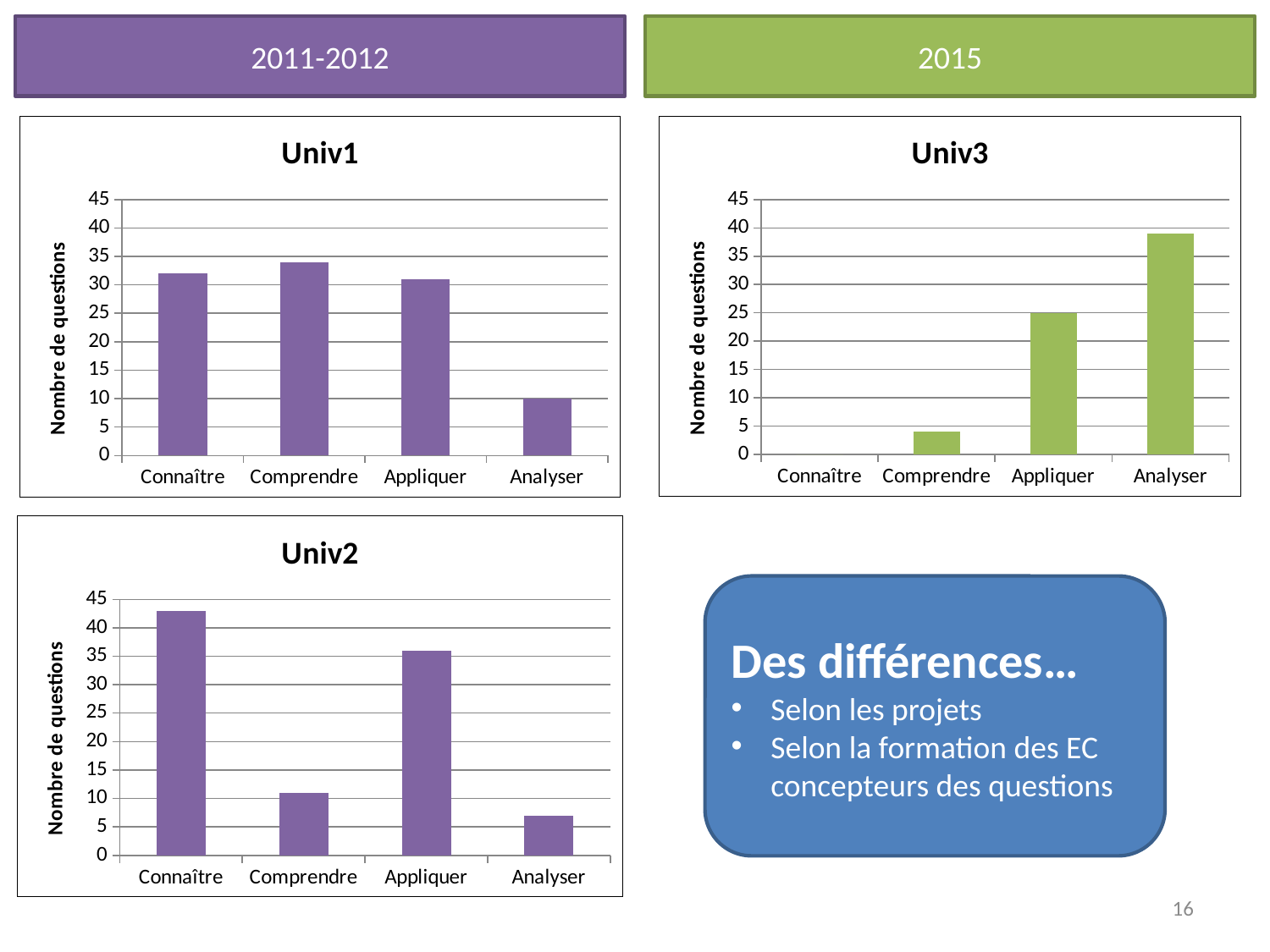
In the Univ2 chart, which category has the highest value? Connaître In the Univ2 chart, which is larger, Appliquer or Comprendre? Appliquer In the Univ2 chart, which category has the lowest value? Analyser What is the y-axis title of the Univ2 chart? Nombre de questions How many categories are shown on the x axis of the Univ1 chart? 4 In the Univ1 chart, which category has the lowest value? Analyser In the Univ2 chart, is the value for Connaître greater or less than 40? greater In the Univ3 chart, is the value for Comprendre greater or less than 5? less In the Univ3 chart, what is the value for Appliquer? 25 In the Univ3 chart, which category has the lowest value? Connaître In the Univ1 chart, what is the value for Analyser? 10 In the Univ3 chart, which category has the highest value? Analyser